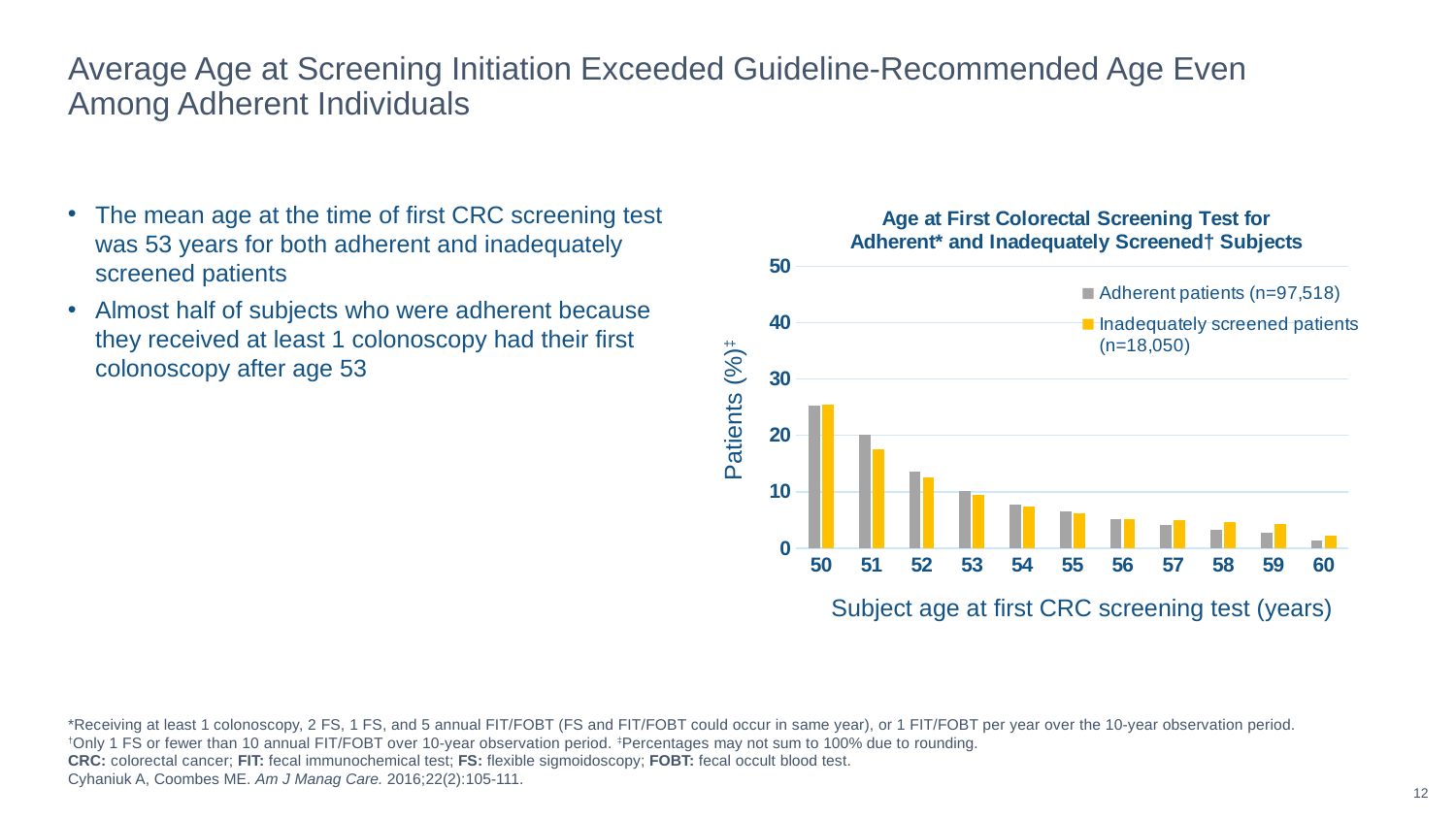
At age 51, which series has the larger value: adherent patients or inadequately screened patients? Adherent patients At which subject age is the percentage of adherent patients highest? 50 What kind of chart is shown on the slide? Bar chart Is the value for adherent patients at age 50 greater or less than 20? greater How many series does the chart legend list? 2 Do the percentages of adherent patients rise or fall as subject age increases from 50 to 60? Fall What is the sample size (n) given in the legend for adherent patients? n=97,518 At age 59, which series has the larger value: adherent patients or inadequately screened patients? Inadequately screened patients How many age categories are shown on the x axis of the chart? 11 At which subject age is the percentage of inadequately screened patients lowest? 60 Is the value for adherent patients at age 50 greater or less than 30? less